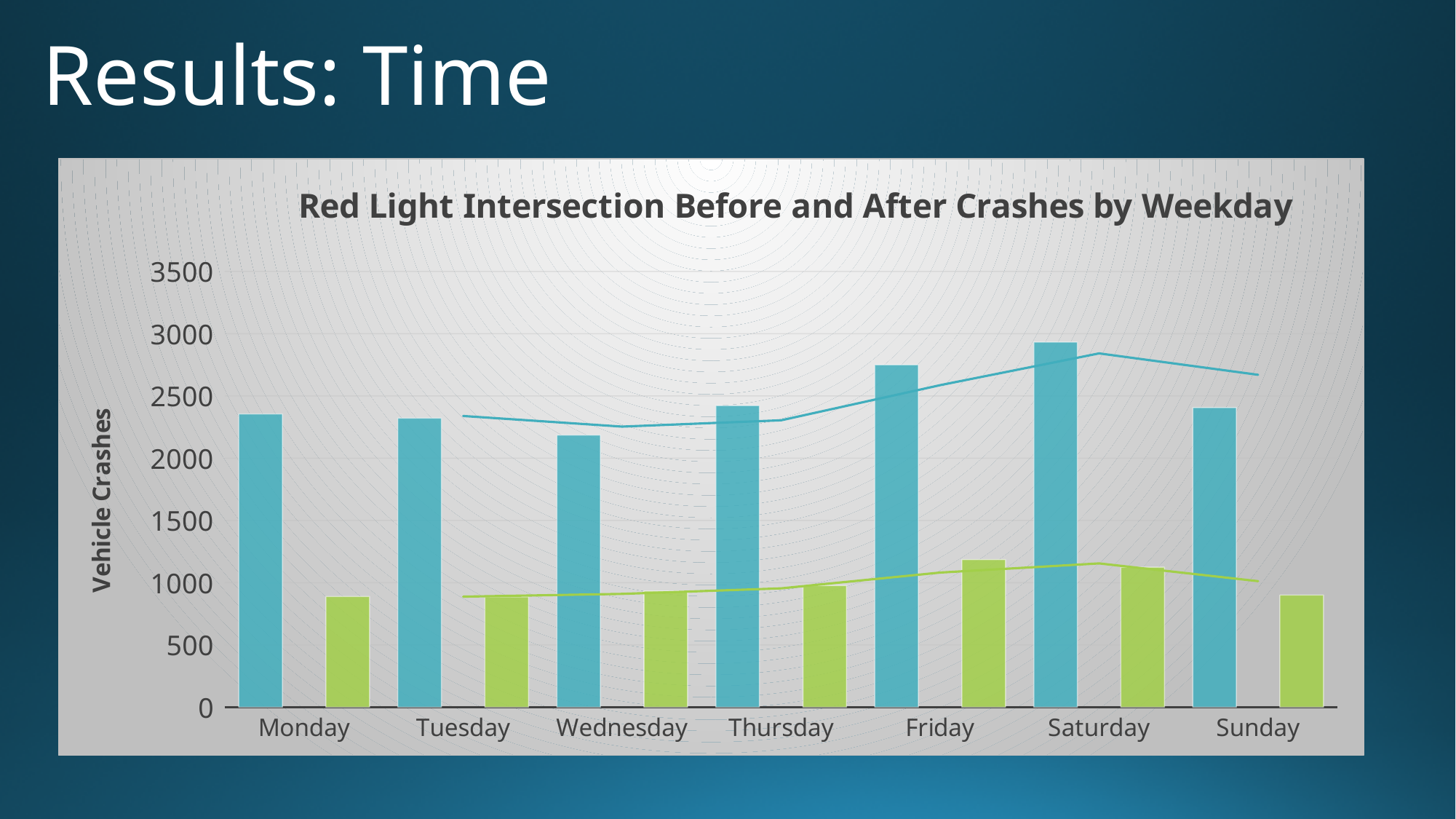
What is the label on the vertical axis of the chart? Vehicle Crashes On which weekday is the blue bar the lowest? Wednesday Is the green bar for Monday greater or less than 1000? less What is the title of the chart? Red Light Intersection Before and After Crashes by Weekday Is the blue bar for Wednesday greater or less than 2500? less How many weekday categories are shown on the x axis? 7 On which weekday is the green bar the highest? Friday Which is larger, the blue bar for Friday or the blue bar for Thursday? Friday What kind of chart is shown on the slide? bar chart Is the green bar for Friday greater or less than 1000? greater On which weekday is the blue bar the highest? Saturday